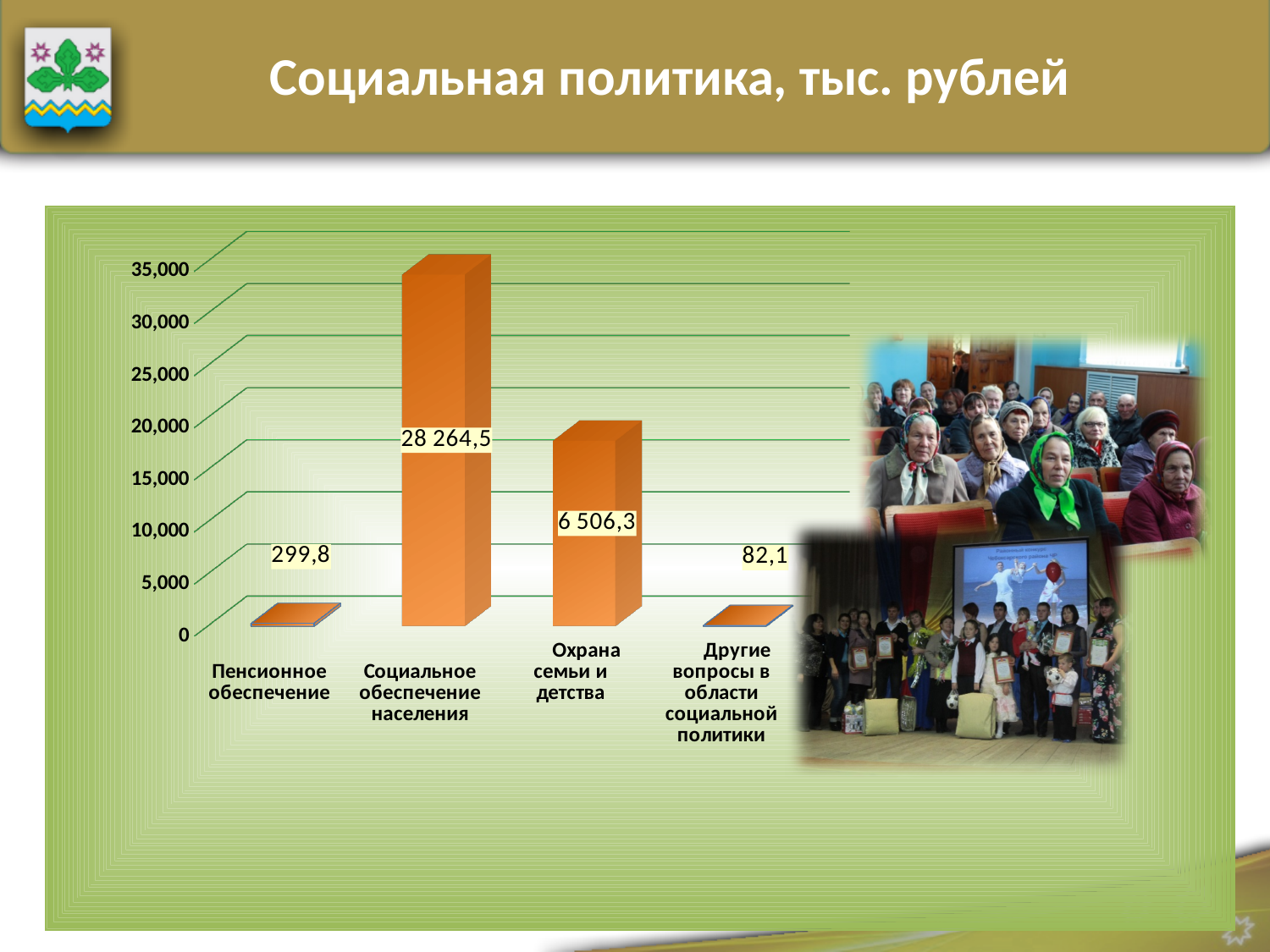
What is the value for Пенсионное обеспечение? 299,8 Is the value for Социальное обеспечение населения greater or less than 25,000? greater What kind of chart is shown on the slide? bar chart What is the difference between the values for Социальное обеспечение населения and Охрана семьи и детства? 21 758,2 What is the difference between the values for Пенсионное обеспечение and Другие вопросы в области социальной политики? 217,7 What is the value for Социальное обеспечение населения? 28 264,5 How many categories are shown in the chart? 4 What is the value for Охрана семьи и детства? 6 506,3 Which category has the lowest value? Другие вопросы в области социальной политики Which is larger, the value for Охрана семьи и детства or the value for Пенсионное обеспечение? Охрана семьи и детства What is the value for Другие вопросы в области социальной политики? 82,1 Which category has the highest value? Социальное обеспечение населения